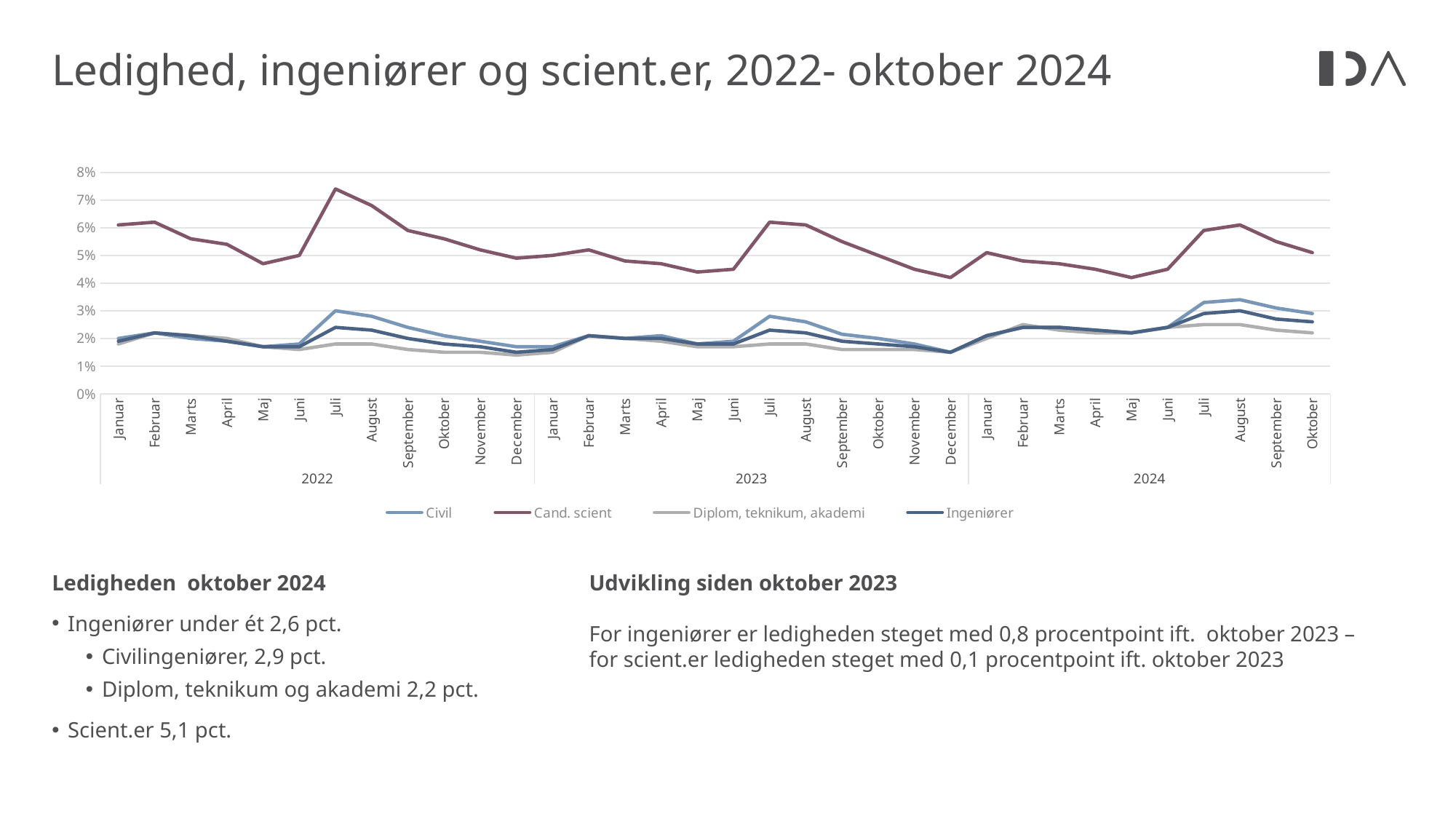
What is the unemployment rate for Diplom, teknikum, akademi in October 2024? 2,2 pct. Is the value for Cand. scient in December 2023 greater or less than 5%? less How many series does the chart legend list? 4 What is the difference between the Civil and the Diplom, teknikum, akademi values in October 2024? 0,7 procentpoint Which series has the highest value in October 2024? Cand. scient What is the unemployment rate for Cand. scient (scient.er) in October 2024? 5,1 pct. Does the Cand. scient line rise or fall from July 2022 to December 2022? fall Which series has the lowest value in October 2024? Diplom, teknikum, akademi What kind of chart is shown on the slide? line chart What is the unemployment rate for Ingeniører in October 2024? 2,6 pct. Is the value for Cand. scient in July 2022 greater or less than 7%? greater What is the unemployment rate for Civil (civilingeniører) in October 2024? 2,9 pct.